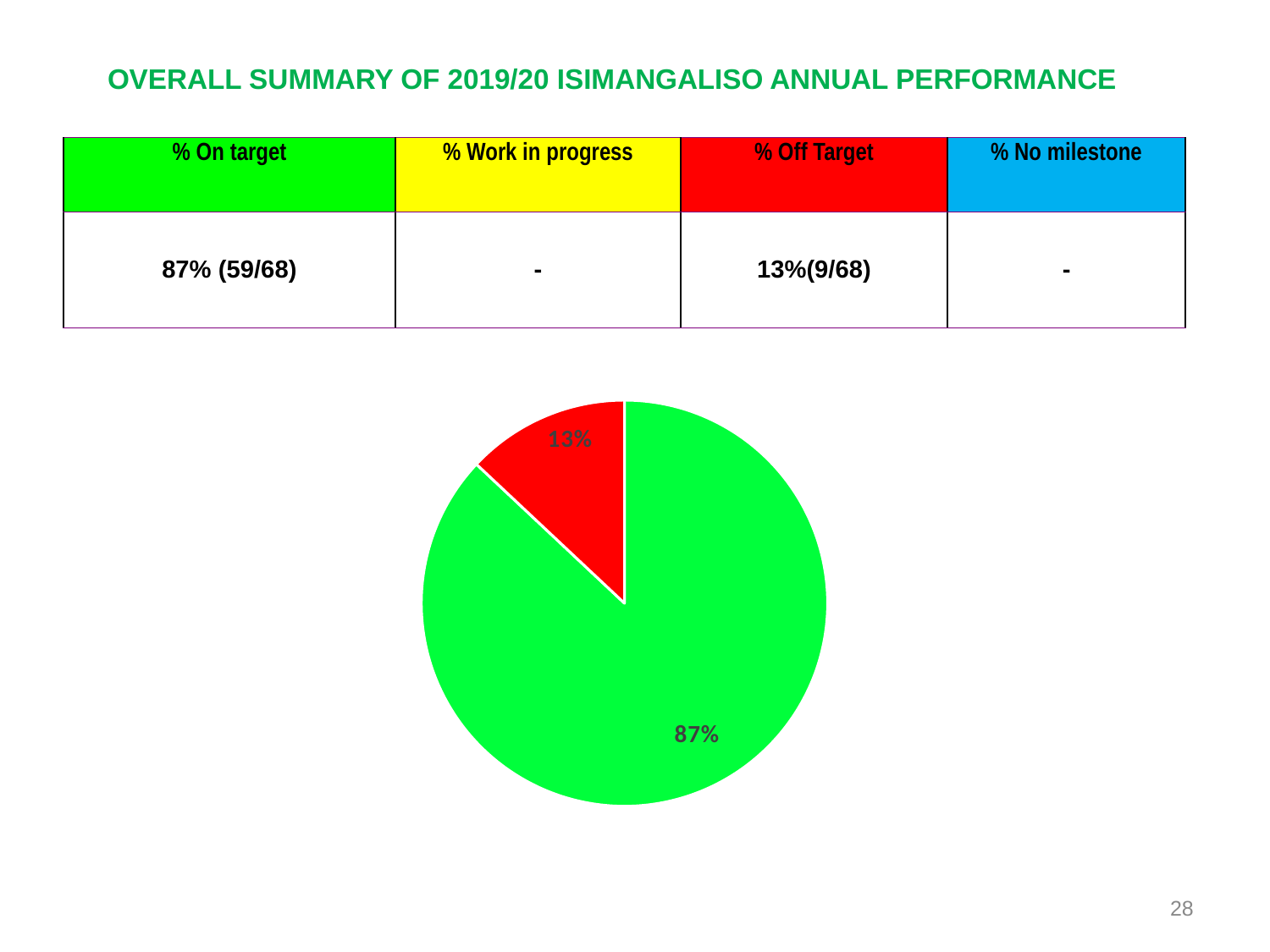
What share of the pie does the red slice represent? 13% What is the total of the two percentages shown on the pie chart? 100% Which slice of the pie chart is the largest? the green slice (87%) What kind of chart is shown on the slide? pie chart According to the table colour coding on the slide, which category does the green slice of the pie chart represent? % On target Is the green slice or the red slice of the pie chart larger? the green slice What percentage is shown on the red slice of the pie chart? 13% According to the table colour coding on the slide, which category does the red slice of the pie chart represent? % Off Target What is the difference in percentage points between the green slice and the red slice of the pie chart? 74 How many slices does the pie chart have? 2 What percentage is shown on the green slice of the pie chart? 87% Which slice of the pie chart is the smallest? the red slice (13%)